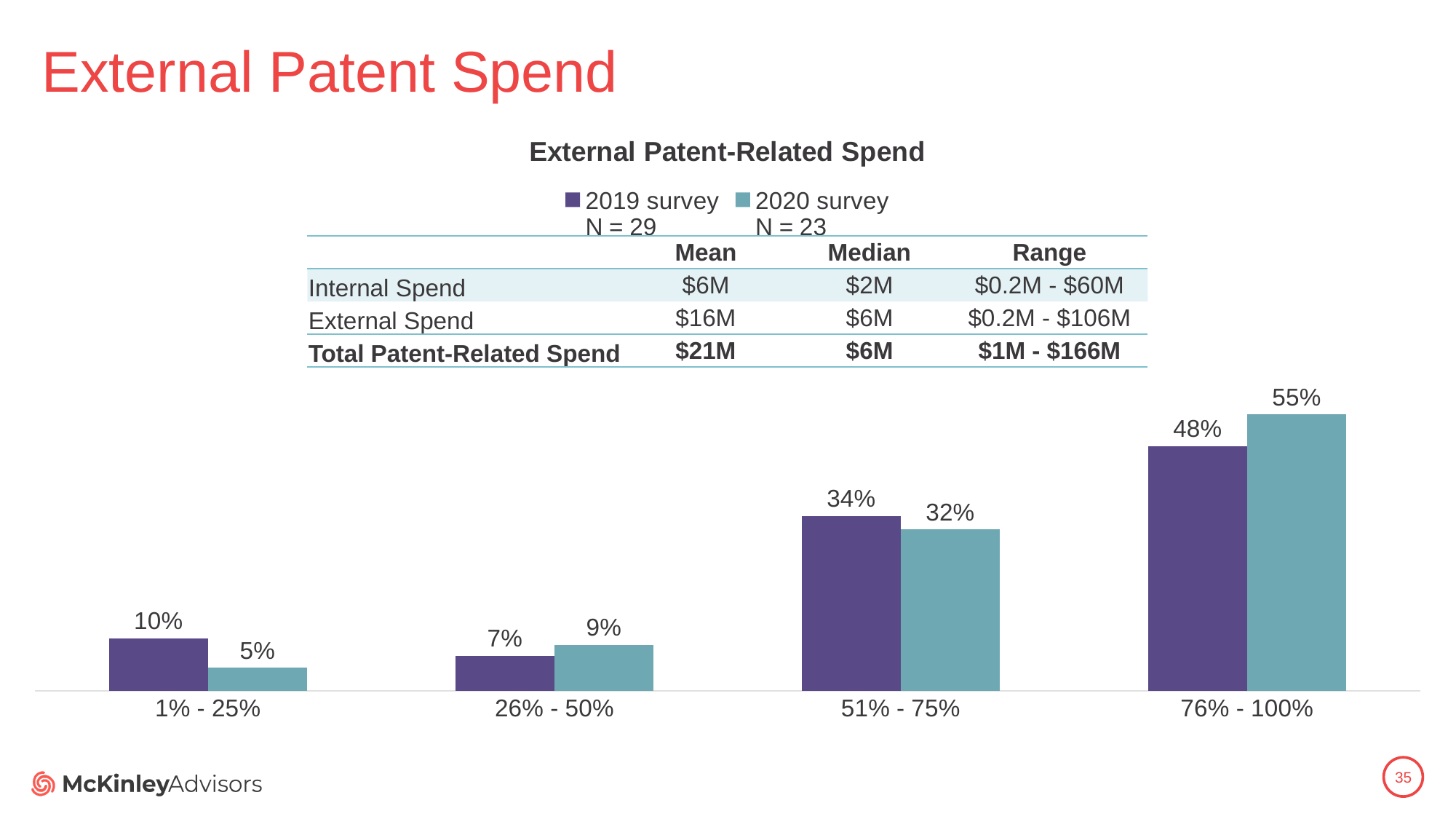
What is the difference between the 2020 survey and 2019 survey values for the 76% - 100% category? 7% What is the 2019 survey value for the 76% - 100% category? 48% Which category has the highest 2020 survey value? 76% - 100% Which is larger for the 51% - 75% category, the 2019 survey value or the 2020 survey value? 2019 survey What is the title of the chart? External Patent-Related Spend What is the sample size (N) for the 2019 survey shown in the legend? N = 29 What is the 2020 survey value for the 51% - 75% category? 32% What is the 2020 survey value for the 1% - 25% category? 5% Which category has the lowest 2019 survey value? 26% - 50% What kind of chart is shown on the slide? Bar chart How many series does the legend list? 2 How many categories are shown on the x axis? 4